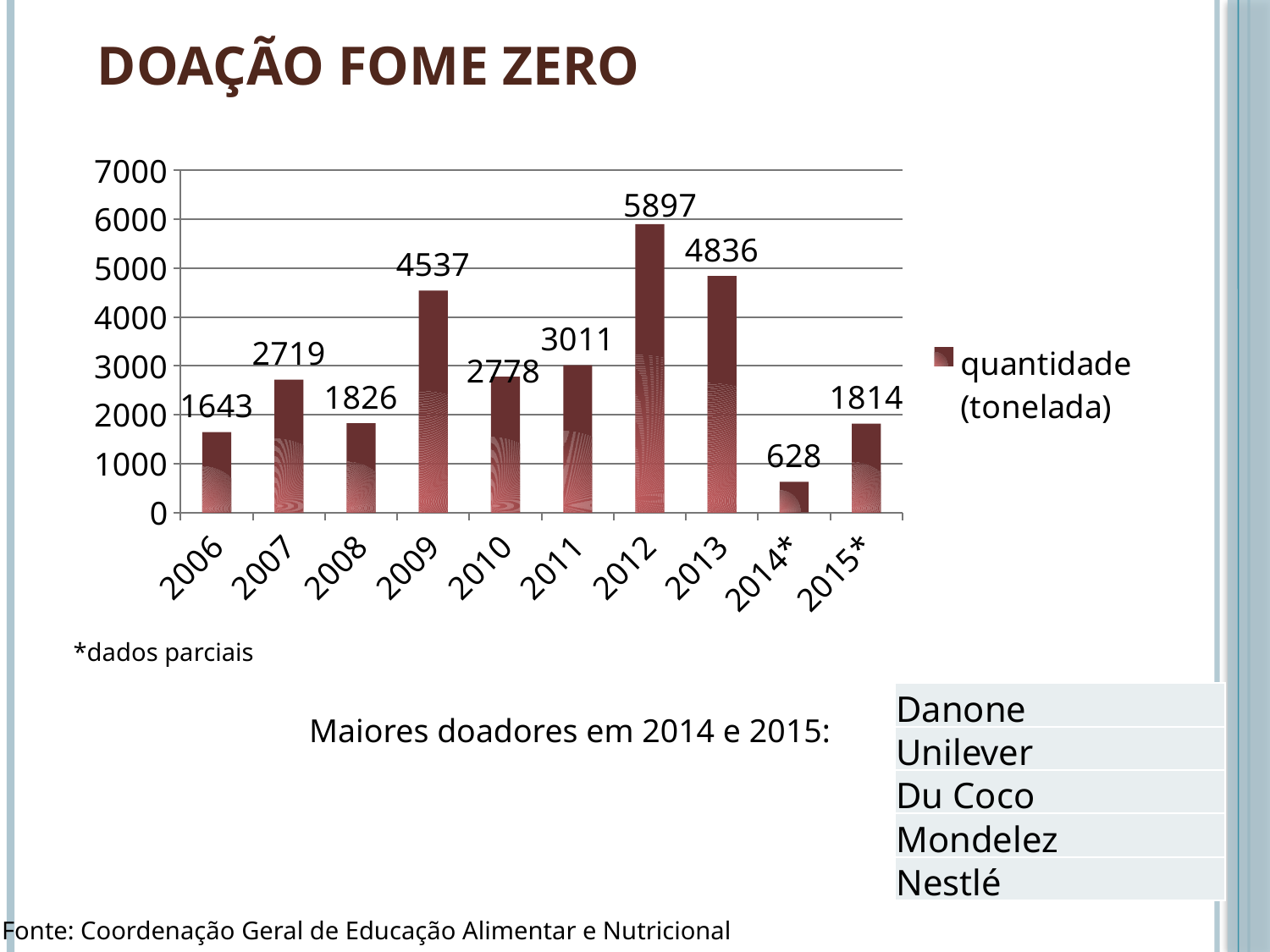
What kind of chart is shown? bar chart Is the value for 2007 greater or less than 2000? greater What is the difference between the values for 2012 and 2013? 1061 Which year has the lowest value? 2014* Which year has the highest value? 2012 What is the legend entry for the series? quantidade (tonelada) How many years are shown on the x axis? 10 What is the value for 2009? 4537 What is the value for 2014*? 628 What is the value for 2012? 5897 Which is larger, the value for 2010 or the value for 2011? 2011 How many series does the legend list? 1